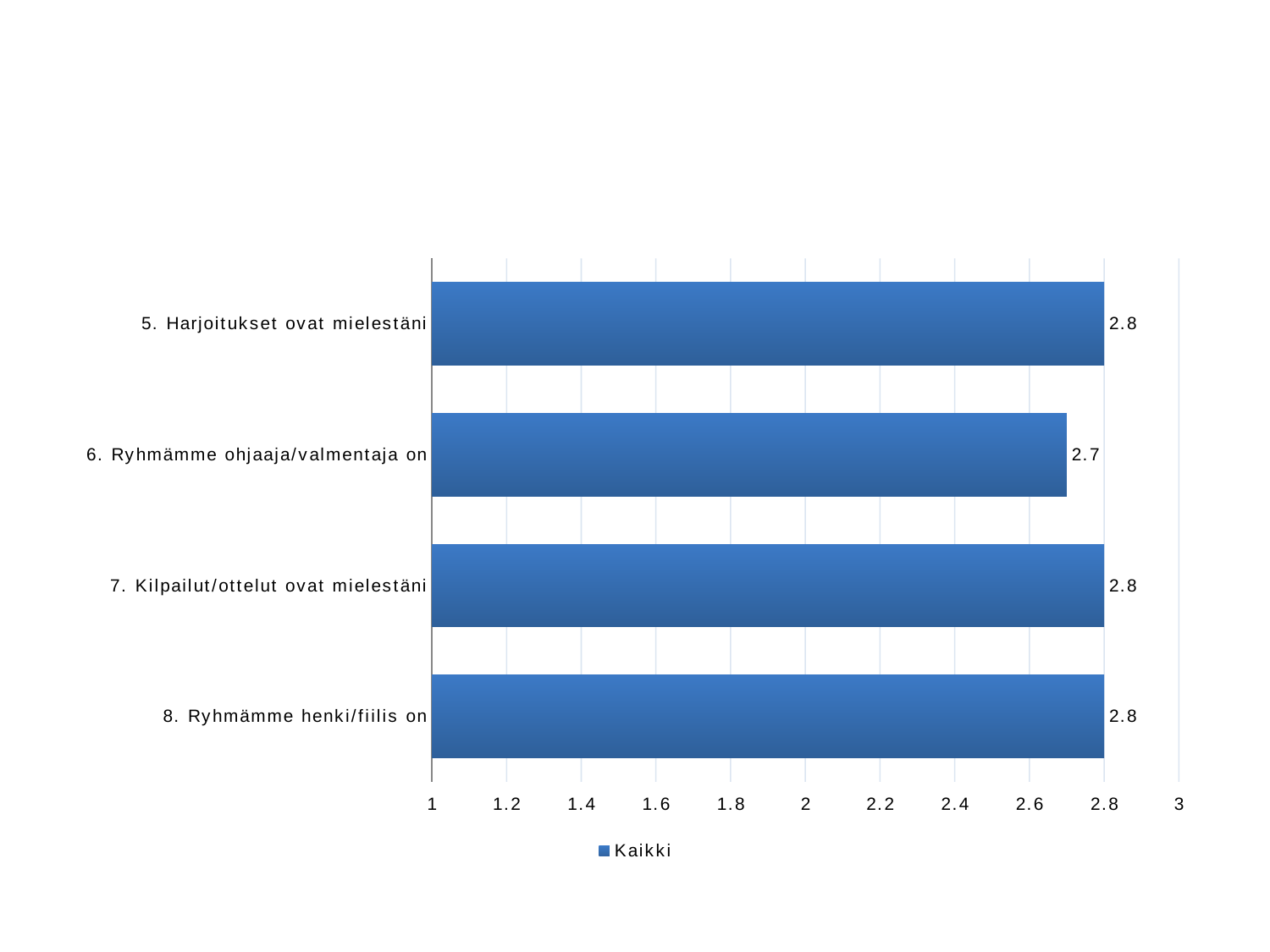
What is the value for "5. Harjoitukset ovat mielestäni"? 2.8 How many categories are shown in the chart? 4 What is the value for "6. Ryhmämme ohjaaja/valmentaja on"? 2.7 What is the maximum value shown on the x axis? 3 How many series does the legend list? 1 What is the value for "8. Ryhmämme henki/fiilis on"? 2.8 Is the value for "6. Ryhmämme ohjaaja/valmentaja on" greater or less than 2? greater What is the name of the series shown in the legend? Kaikki What kind of chart is shown on the slide? bar chart What is the difference between the values for "7. Kilpailut/ottelut ovat mielestäni" and "6. Ryhmämme ohjaaja/valmentaja on"? 0.1 Which is larger, the value for "5. Harjoitukset ovat mielestäni" or the value for "6. Ryhmämme ohjaaja/valmentaja on"? 5. Harjoitukset ovat mielestäni Which category has the lowest value? 6. Ryhmämme ohjaaja/valmentaja on